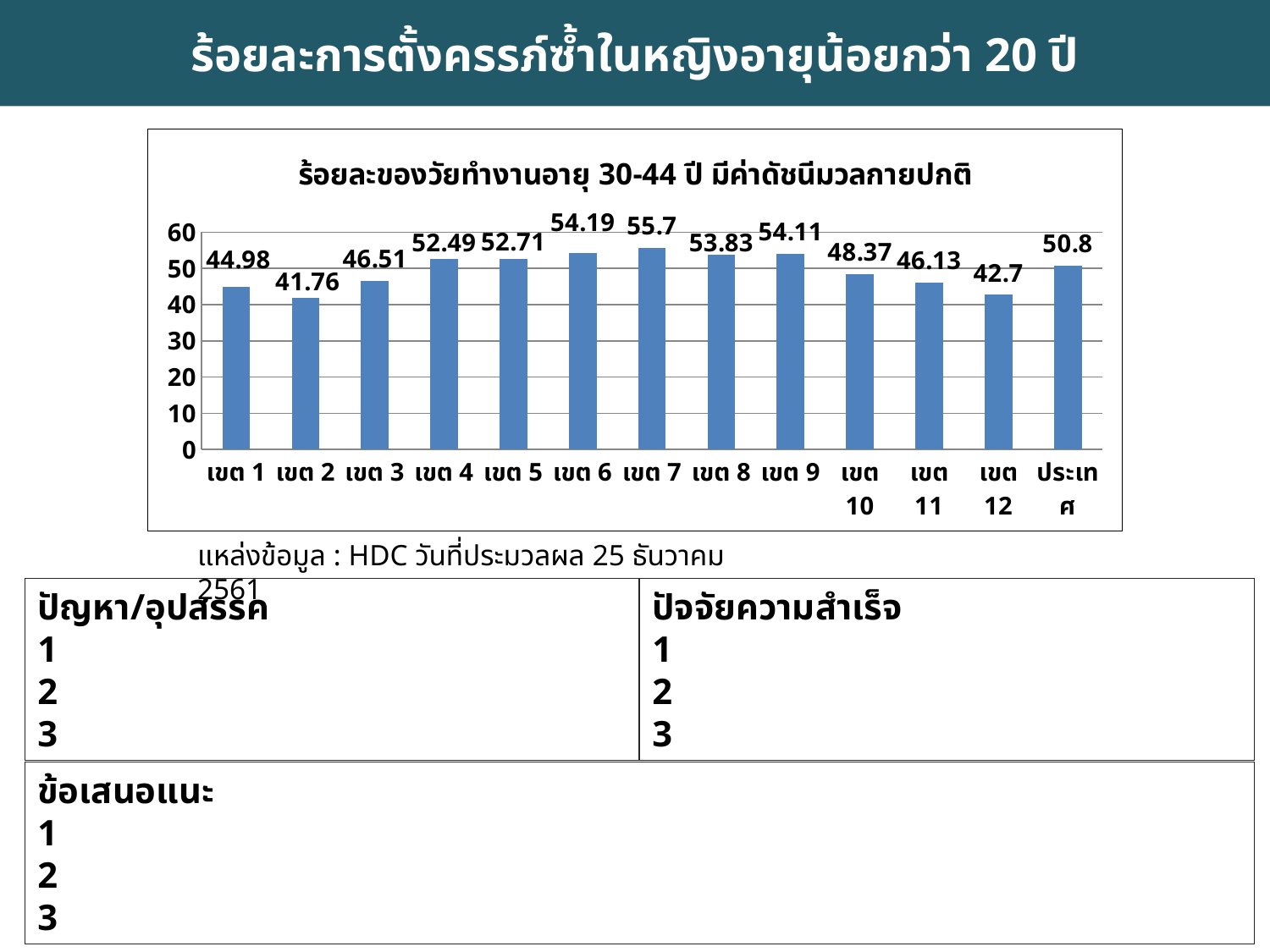
What is the value for ประเทศ? 50.8 Is the value for เขต 1 greater or less than 50? less What is the difference between the values for ประเทศ and เขต 12? 8.1 What is the difference between the values for เขต 7 and เขต 2? 13.94 Which category has the lowest value? เขต 2 How many categories are shown on the x axis? 13 Which is larger, the value for เขต 4 or the value for เขต 10? เขต 4 What kind of chart is shown on the slide? bar chart What is the title of the chart? ร้อยละของวัยทำงานอายุ 30-44 ปี มีค่าดัชนีมวลกายปกติ What is the value for เขต 11? 46.13 Which category has the highest value? เขต 7 What is the value for เขต 7? 55.7